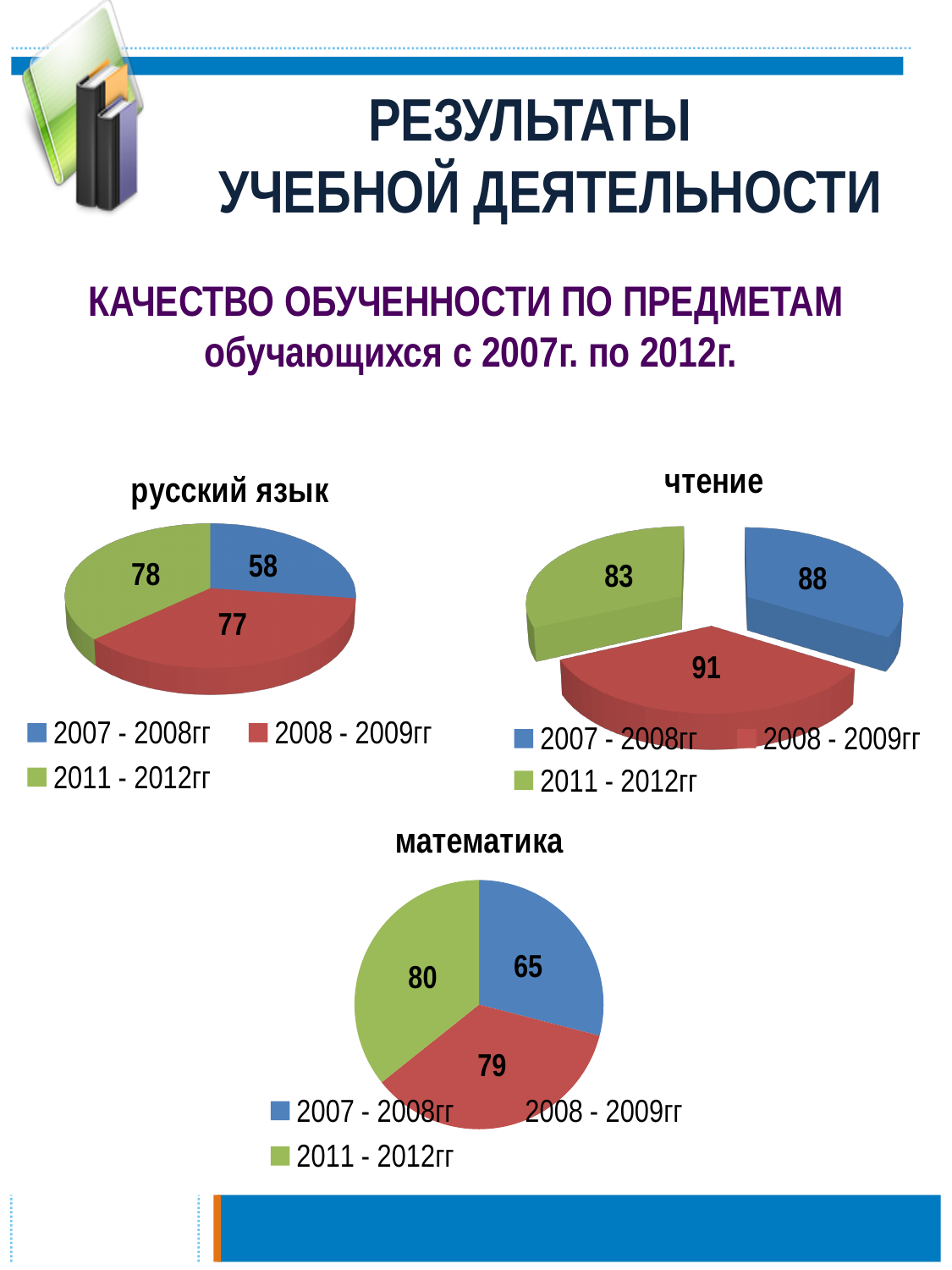
In the 'математика' chart, what is the value for 2011 - 2012гг? 80 In the 'русский язык' chart, what is the difference between the values for 2011 - 2012гг and 2007 - 2008гг? 20 In the 'чтение' chart, what is the difference between the values for 2008 - 2009гг and 2011 - 2012гг? 8 How many slices does the 'чтение' chart have? 3 In the 'математика' chart, which is larger: the value for 2008 - 2009гг or 2007 - 2008гг? 2008 - 2009гг What type of chart is the 'математика' chart? Pie chart How many charts are shown on the slide? 3 In the 'чтение' chart, what is the value for 2008 - 2009гг? 91 In the 'математика' chart, which period has the lowest value? 2007 - 2008гг In the 'чтение' chart, which period has the highest value? 2008 - 2009гг In the 'русский язык' chart, what is the value for 2007 - 2008гг? 58 In the 'русский язык' chart, which period has the lowest value? 2007 - 2008гг